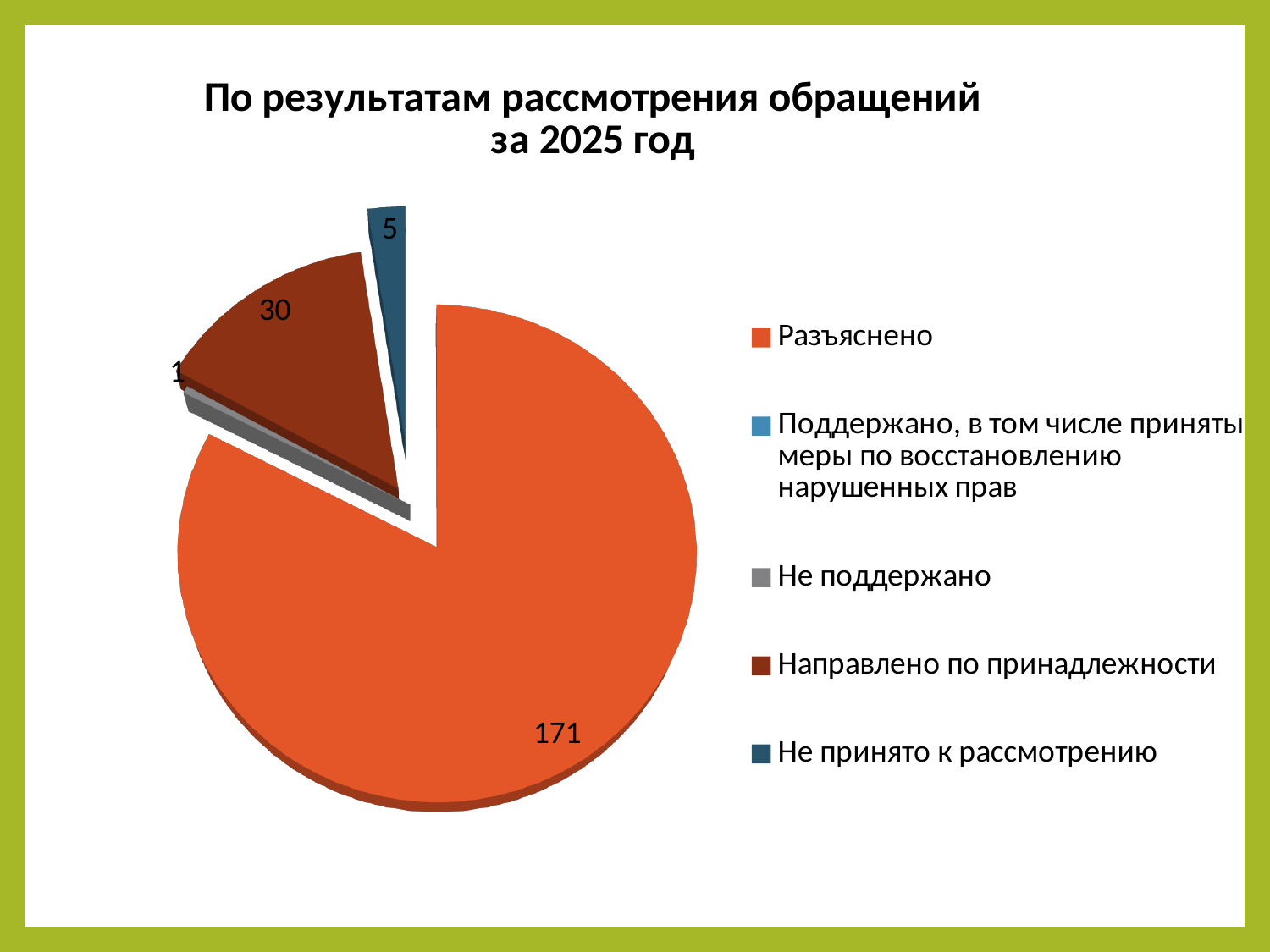
Which category has the largest slice of the pie? Разъяснено What is the difference between the values for Разъяснено and Направлено по принадлежности? 141 What is the value for Разъяснено? 171 What type of chart is shown on the slide? Pie chart What colour is the slice for Разъяснено? Orange What is the value for Не поддержано? 1 What is the difference between the values for Направлено по принадлежности and Не принято к рассмотрению? 25 What is the value for Направлено по принадлежности? 30 Which is larger: Направлено по принадлежности or Не принято к рассмотрению? Направлено по принадлежности What is the value for Не принято к рассмотрению? 5 What is the title of the chart? По результатам рассмотрения обращений за 2025 год How many categories does the legend list? 5